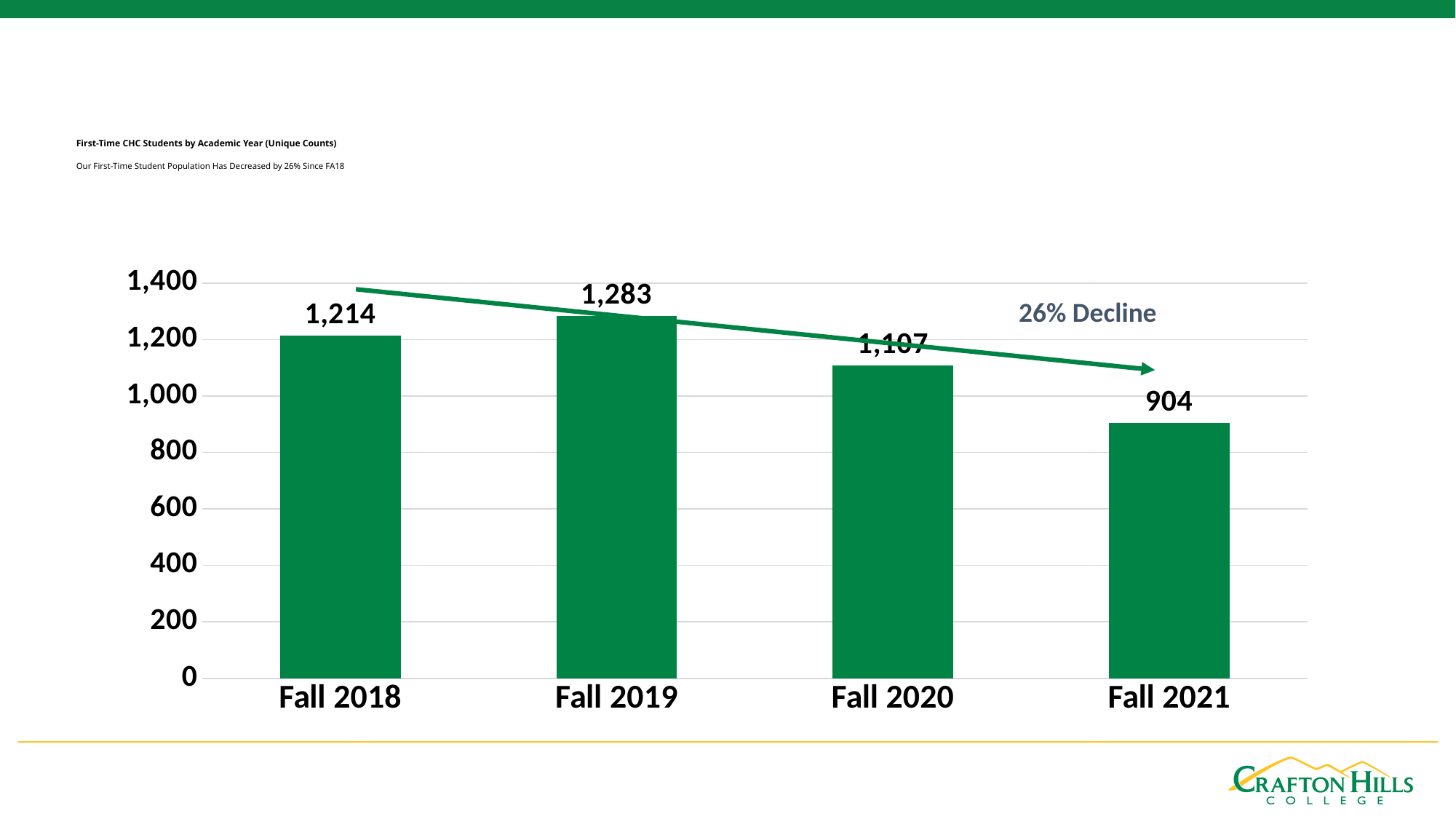
Which category has the lowest value? Fall 2021 What percentage decline is annotated on the chart? 26% Decline What is the value for Fall 2020? 1,107 What is the value for Fall 2019? 1,283 Which category has the highest value? Fall 2019 What is the value for Fall 2018? 1,214 Which is larger, the value for Fall 2018 or the value for Fall 2020? Fall 2018 Is the value for Fall 2021 greater or less than 1,000? less What is the difference between the values for Fall 2019 and Fall 2021? 379 What is the value for Fall 2021? 904 What kind of chart is shown on the slide? bar chart How many categories are shown on the x axis? 4